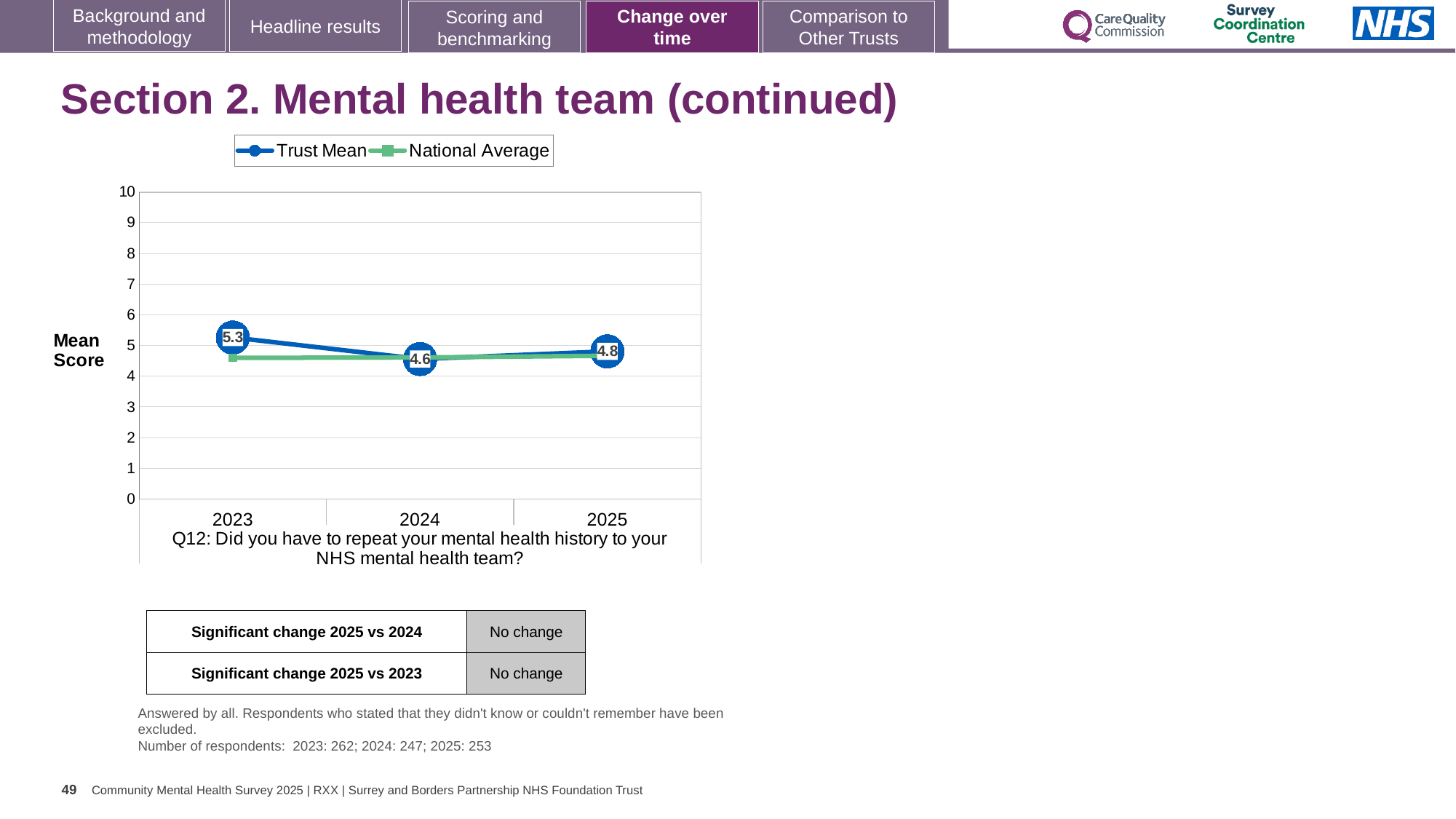
Does the Trust Mean rise or fall from 2023 to 2024? Fall How many years are shown on the x axis? 3 In which year is the Trust Mean highest? 2023 What is the Trust Mean score for 2024? 4.6 What is the difference between the Trust Mean in 2023 and in 2024? 0.7 Is the National Average value for 2023 greater or less than 5? less In which year is the Trust Mean lowest? 2024 What kind of chart is shown on the slide? Line chart What is the Trust Mean score for 2023? 5.3 What is the Trust Mean score for 2025? 4.8 How many series does the legend list? 2 Which is larger, the Trust Mean in 2025 or the Trust Mean in 2024? 2025